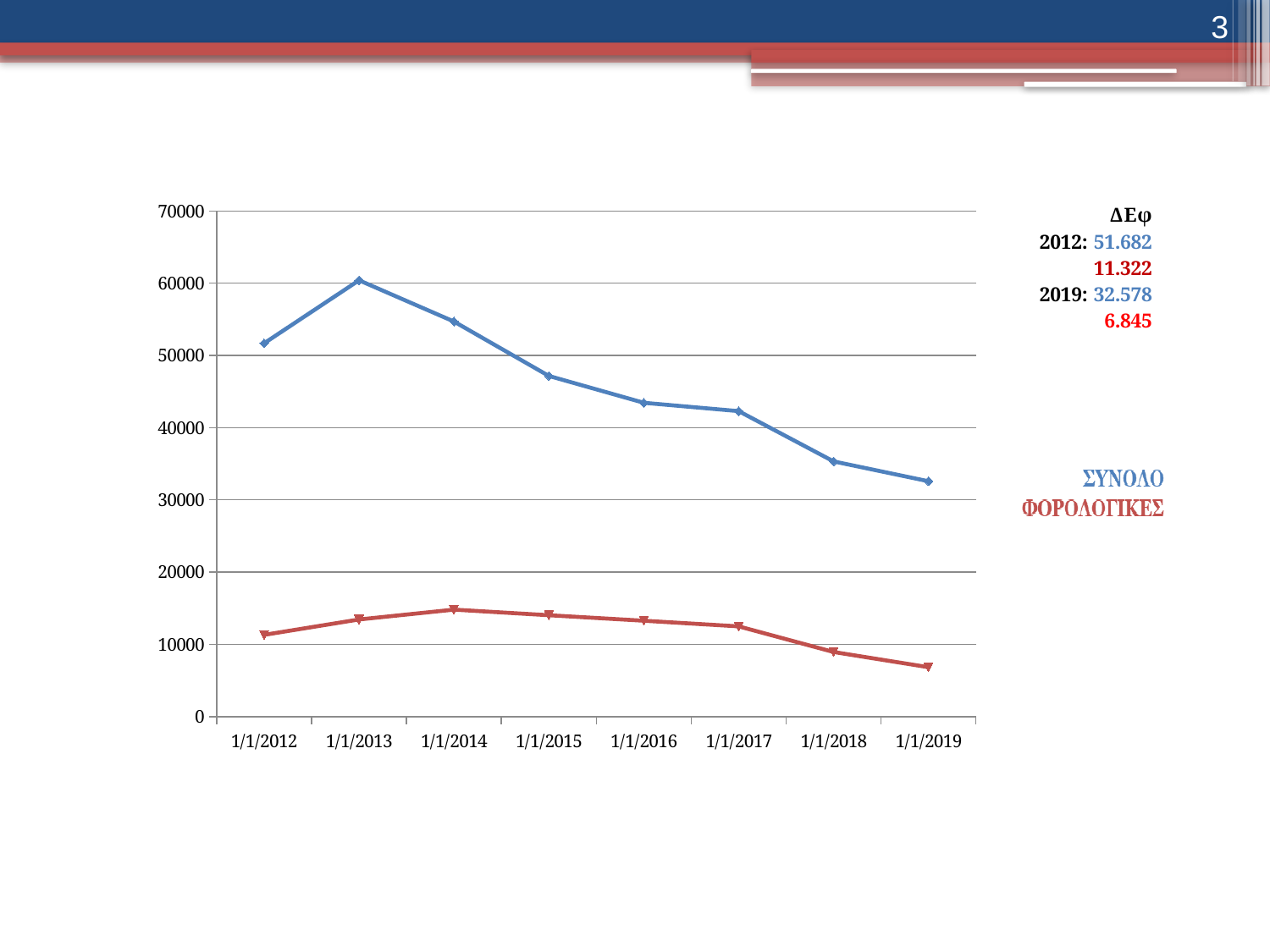
On which date does the ΦΟΡΟΛΟΓΙΚΕΣ series reach its highest value? 1/1/2014 According to the text on the slide, what is the ΣΥΝΟΛΟ value for 2012? 51.682 On which date does the ΣΥΝΟΛΟ series reach its lowest value? 1/1/2019 How many dates are plotted along the x axis? 8 What colour is the ΣΥΝΟΛΟ line? blue Is the ΣΥΝΟΛΟ value at 1/1/2015 greater or less than 50000? less Does the ΣΥΝΟΛΟ series rise or fall from 1/1/2013 to 1/1/2019? fall Is the ΦΟΡΟΛΟΓΙΚΕΣ value at 1/1/2014 greater or less than 10000? greater At 1/1/2016, which series has the larger value, ΣΥΝΟΛΟ or ΦΟΡΟΛΟΓΙΚΕΣ? ΣΥΝΟΛΟ On which date does the ΣΥΝΟΛΟ series reach its highest value? 1/1/2013 What kind of chart is shown on the slide? line chart